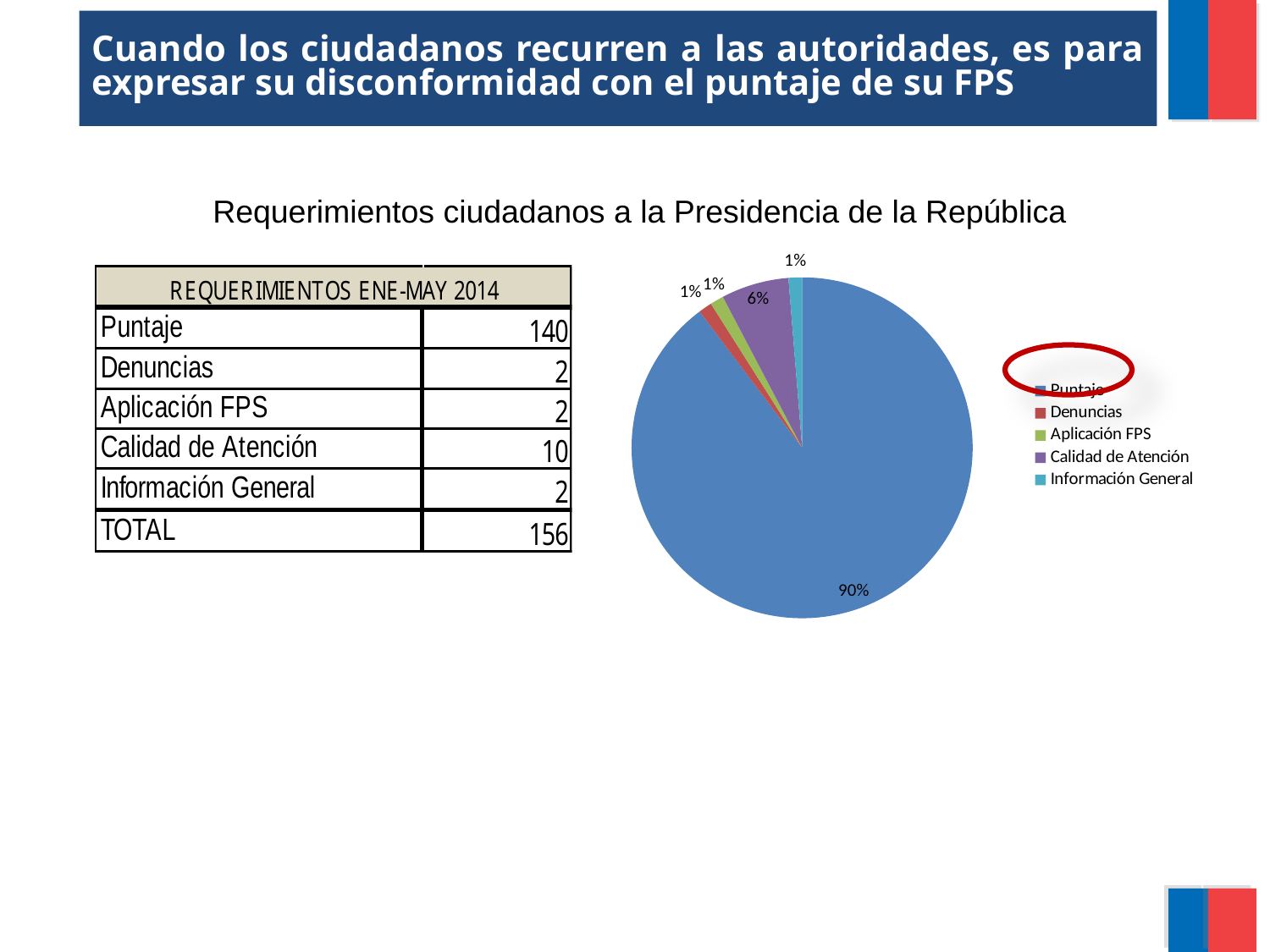
What is the difference in percentage points between the Puntaje slice and the Calidad de Atención slice? 84 What kind of chart is shown on the slide? pie chart What share of the pie does Denuncias represent? 1% What share of the pie does Puntaje represent? 90% How many slices does the pie chart have? 5 How many entries does the pie chart's legend list? 5 What share of the pie does Calidad de Atención represent? 6% Which legend entry is circled in red on the slide? Puntaje Is the share for Puntaje greater or less than 50%? greater Which is larger in the pie chart, Calidad de Atención or Información General? Calidad de Atención Which category has the largest slice of the pie chart? Puntaje What colour is the Calidad de Atención slice in the pie chart? purple